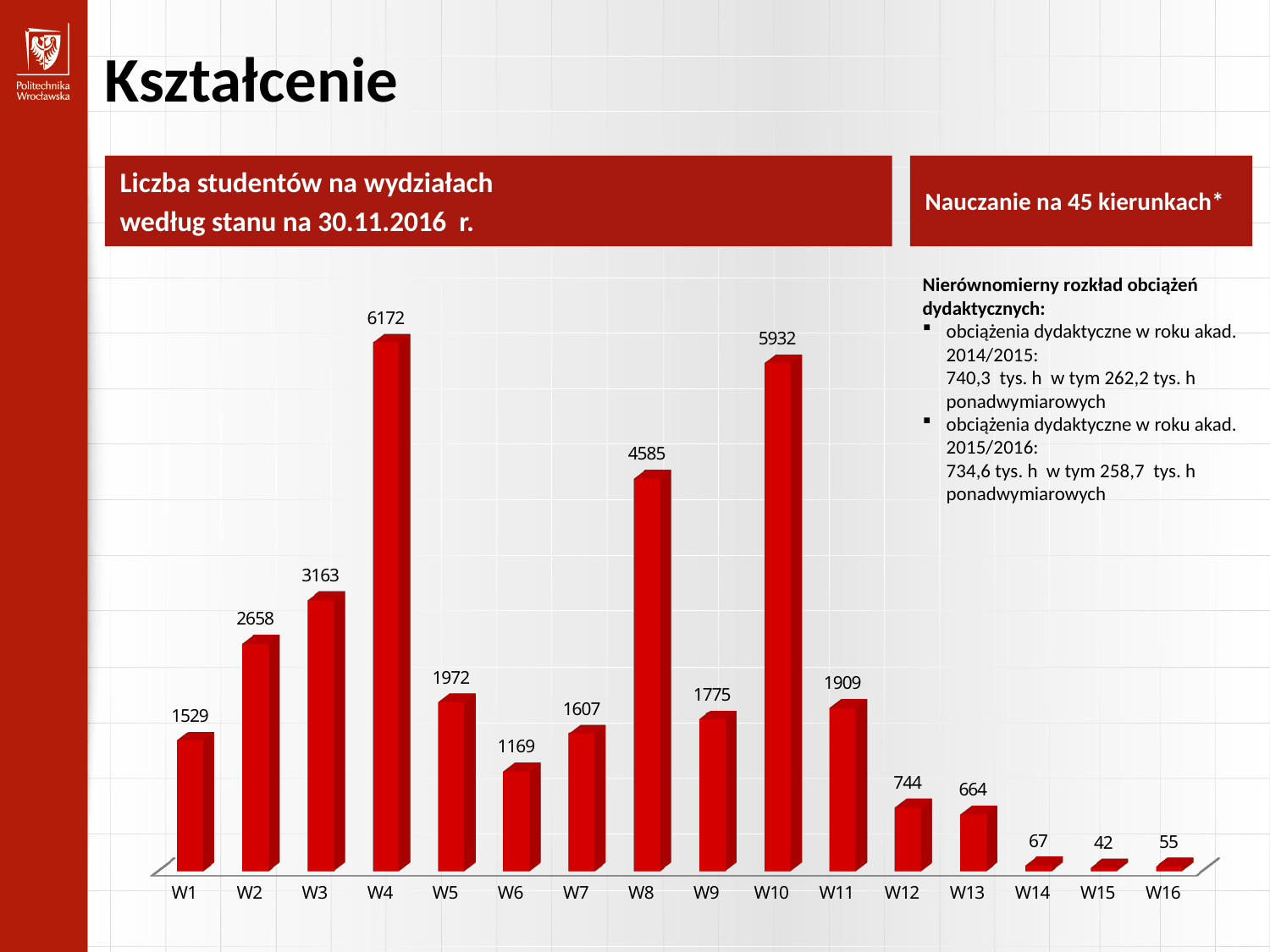
Which has more students, W5 or W11? W5 What is the difference between the values for W10 and W8? 1347 What is the difference between the values for W3 and W2? 505 What is the number of students for W4? 6172 Which faculty has the lowest number of students? W15 Which has more students, W14 or W16? W14 Which faculty has the highest number of students? W4 What is the number of students for W12? 744 How many faculties (categories) are shown on the x axis? 16 What is the value shown for W8? 4585 What kind of chart is shown on the slide? Bar chart What is the title of the chart on the slide? Liczba studentów na wydziałach według stanu na 30.11.2016 r.